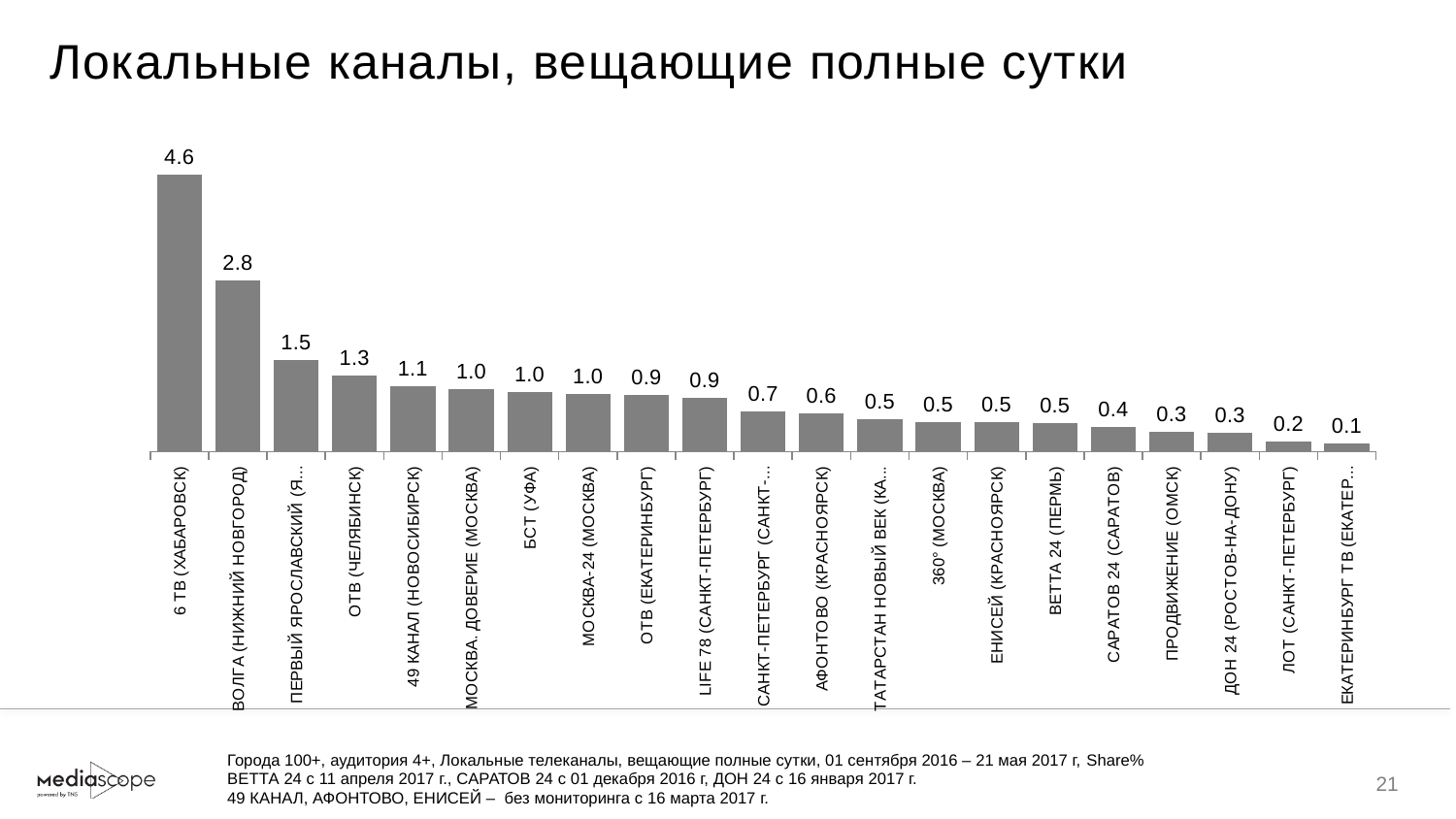
What is the value for БСТ (УФА)? 1.0 Which is larger, the value for ОТВ (ЕКАТЕРИНБУРГ) or the value for САРАТОВ 24 (САРАТОВ)? ОТВ (ЕКАТЕРИНБУРГ) How many channels are shown in the chart? 21 What is the difference between the values for 6 ТВ (ХАБАРОВСК) and ВОЛГА (НИЖНИЙ НОВГОРОД)? 1.8 Do the values rise or fall from left to right along the x axis? Fall What is the value for АФОНТОВО (КРАСНОЯРСК)? 0.6 What is the value for 6 ТВ (ХАБАРОВСК)? 4.6 What kind of chart is shown on the slide? Bar chart What is the value for ОТВ (ЧЕЛЯБИНСК)? 1.3 What is the value for ЛОТ (САНКТ-ПЕТЕРБУРГ)? 0.2 Which channel has the highest value? 6 ТВ (ХАБАРОВСК) Which channel has the lowest value? ЕКАТЕРИНБУРГ ТВ (ЕКАТЕРИНБУРГ)